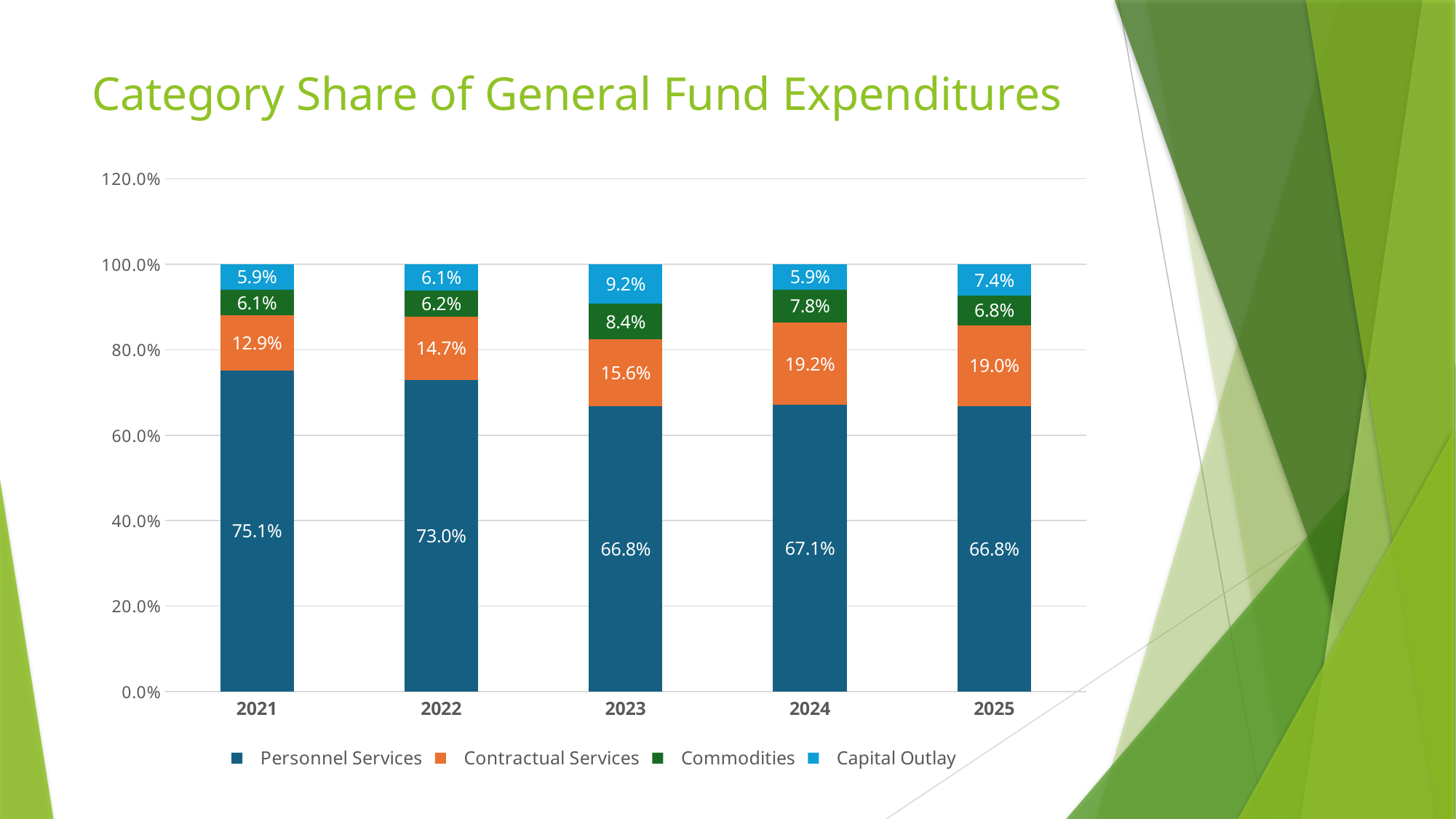
In which year is the Personnel Services share the highest? 2021 By how many percentage points did the Contractual Services share change from 2021 to 2025? 6.1 How many years are shown on the x axis? 5 Which is larger, the Capital Outlay share in 2023 or in 2025? 2023 In which year is the Commodities share the lowest? 2021 How many series does the legend list? 4 What is the Personnel Services share in 2021? 75.1% What is the Contractual Services share in 2024? 19.2% What kind of chart is shown on the slide? Stacked bar chart What is the total of the stacked bar for 2023? 100.0% What is the Capital Outlay share in 2023? 9.2% What is the Commodities share in 2025? 6.8%